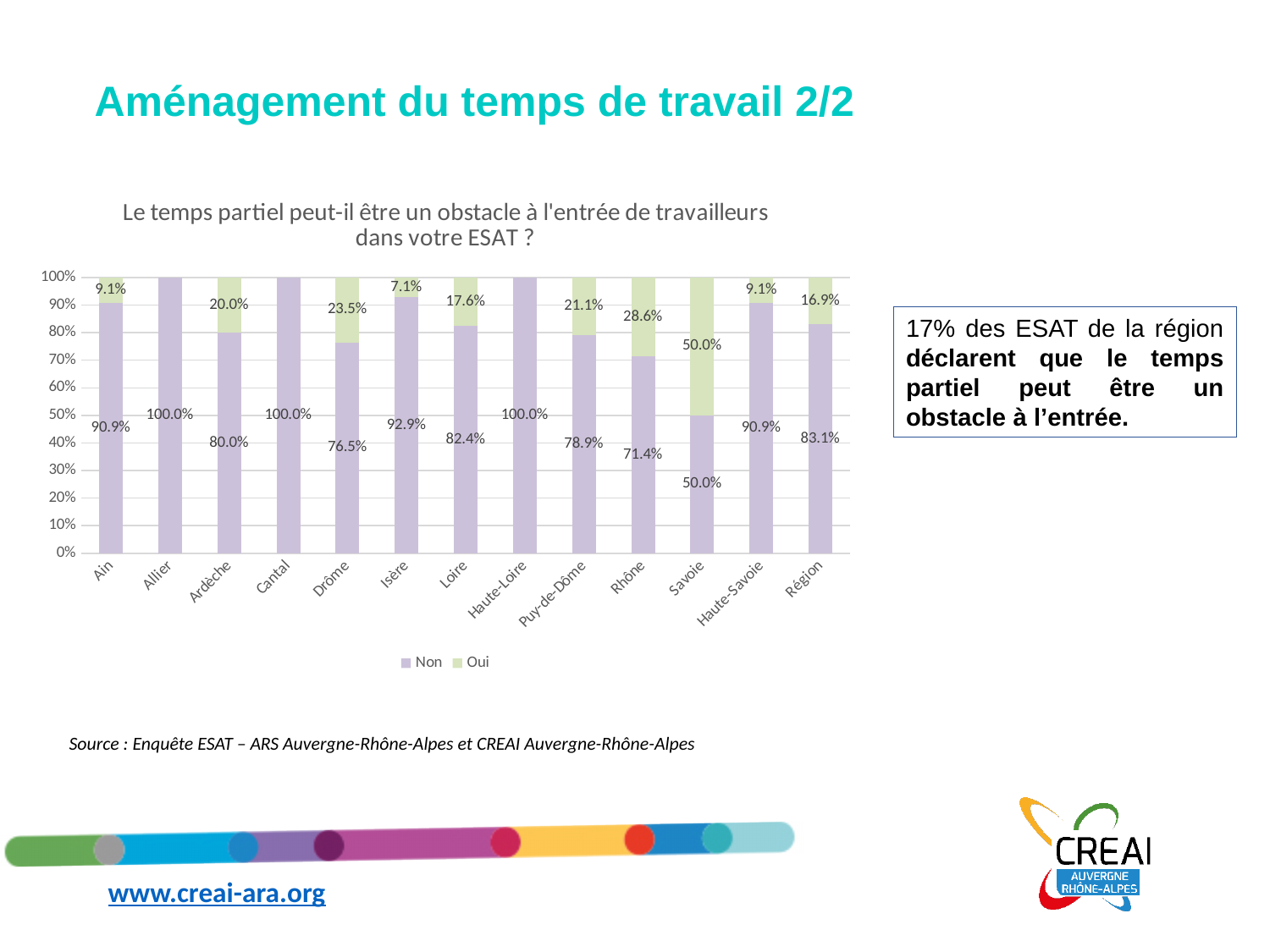
What is the 'Non' value for Drôme? 76.5% Which is larger, the 'Oui' value for Loire or the 'Oui' value for Puy-de-Dôme? Puy-de-Dôme How many series does the chart legend list? 2 Which category has the highest 'Oui' value? Savoie What is the title of the chart? Le temps partiel peut-il être un obstacle à l'entrée de travailleurs dans votre ESAT ? What kind of chart is shown on the slide? Stacked bar chart Which category has the lowest non-zero 'Oui' value? Isère How many categories are shown on the x axis of the chart? 13 What is the 'Oui' value for Région? 16.9% What is the 'Oui' value for Rhône? 28.6% What is the difference between the 'Non' values for Ardèche and Rhône? 8.6% What is the total of the stacked bar for Savoie? 100%